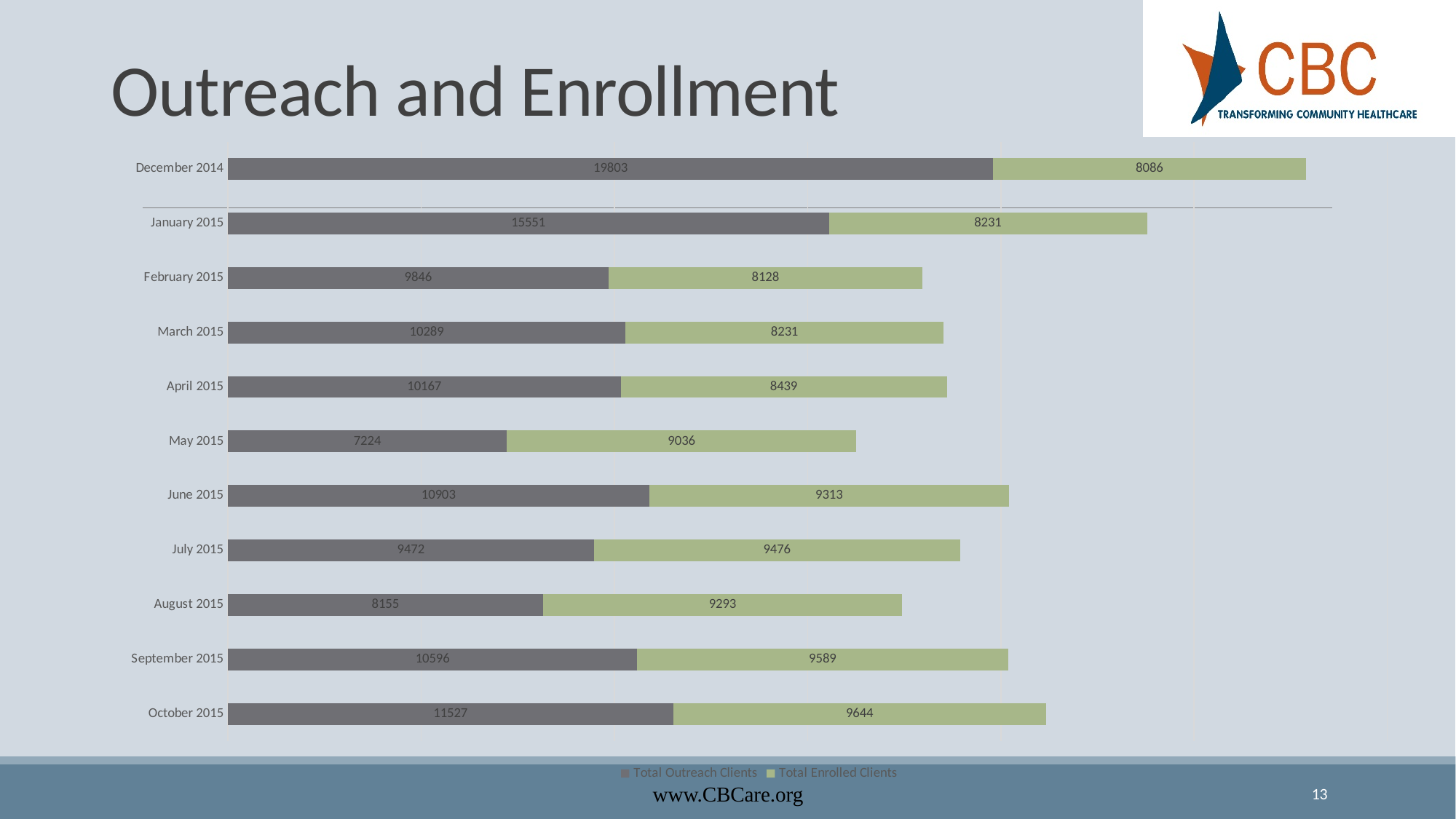
Which month has the lowest value for Total Enrolled Clients? December 2014 What is the total of the stacked bar for October 2015? 21171 What is the value for Total Outreach Clients in December 2014? 19803 What is the value for Total Outreach Clients in May 2015? 7224 Which month has the highest value for Total Outreach Clients? December 2014 Which month has the lowest value for Total Outreach Clients? May 2015 How many months are shown on the chart? 11 What is the difference between Total Outreach Clients in December 2014 and January 2015? 4252 How many series does the legend list? 2 Which is larger in August 2015: Total Outreach Clients or Total Enrolled Clients? Total Enrolled Clients What is the value for Total Enrolled Clients in October 2015? 9644 What kind of chart is shown on the slide? Stacked bar chart